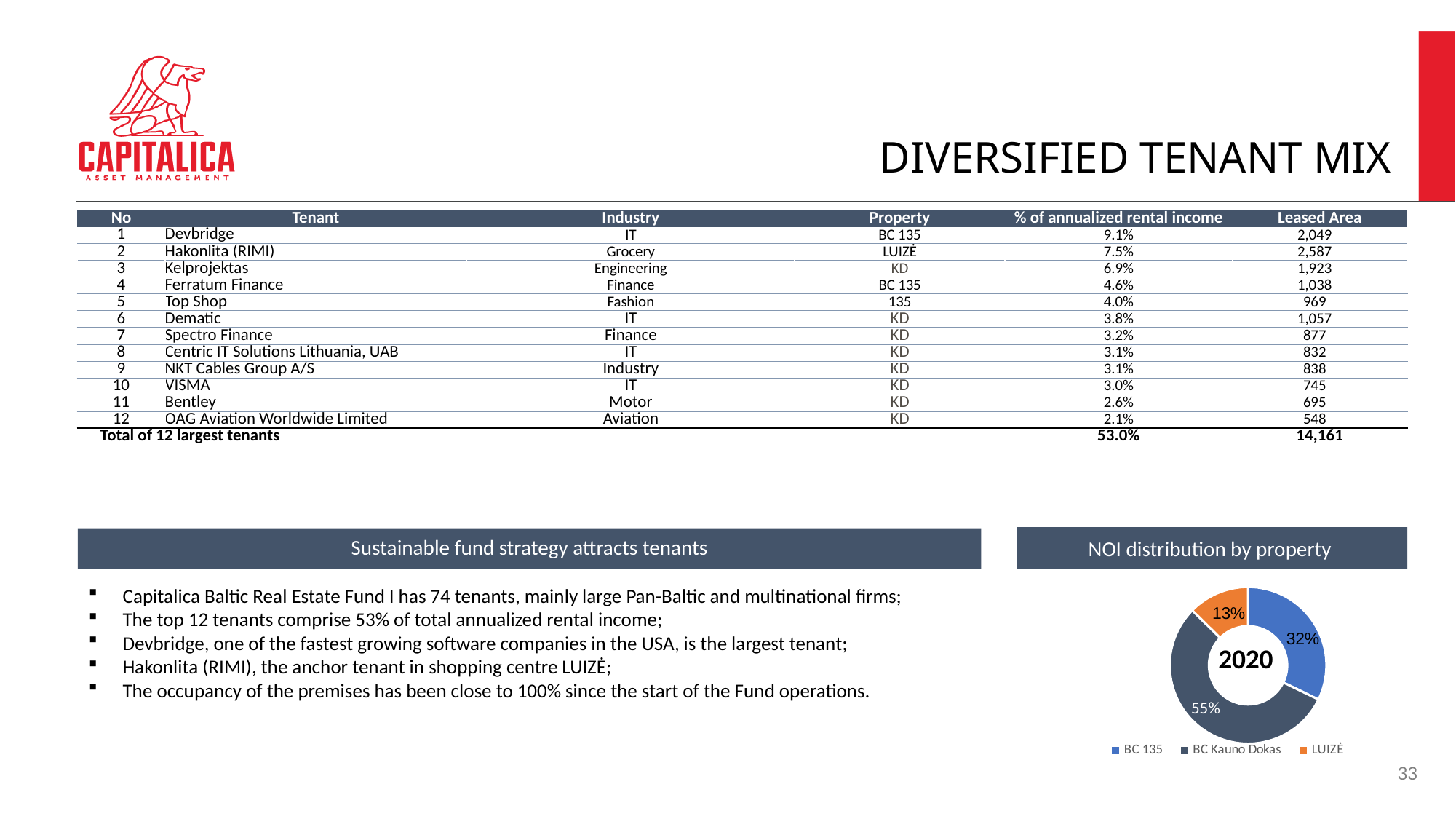
How many properties are shown in the NOI distribution by property chart? 3 What kind of chart is used for the NOI distribution by property? Pie (doughnut) chart What share of NOI does BC Kauno Dokas account for in the NOI distribution by property chart? 55% What share of NOI does LUIZĖ account for in the NOI distribution by property chart? 13% What share of NOI does BC 135 account for in the NOI distribution by property chart? 32% Which property has the smallest share in the NOI distribution by property chart? LUIZĖ How many entries does the legend of the NOI distribution by property chart list? 3 In the NOI distribution by property chart, what is the difference in percentage points between BC 135 and LUIZĖ? 19 percentage points In the NOI distribution by property chart, which has a larger share: BC 135 or LUIZĖ? BC 135 Which property has the largest share in the NOI distribution by property chart? BC Kauno Dokas What year is shown in the centre of the NOI distribution by property chart? 2020 In the NOI distribution by property chart, what is the difference in percentage points between BC Kauno Dokas and BC 135? 23 percentage points